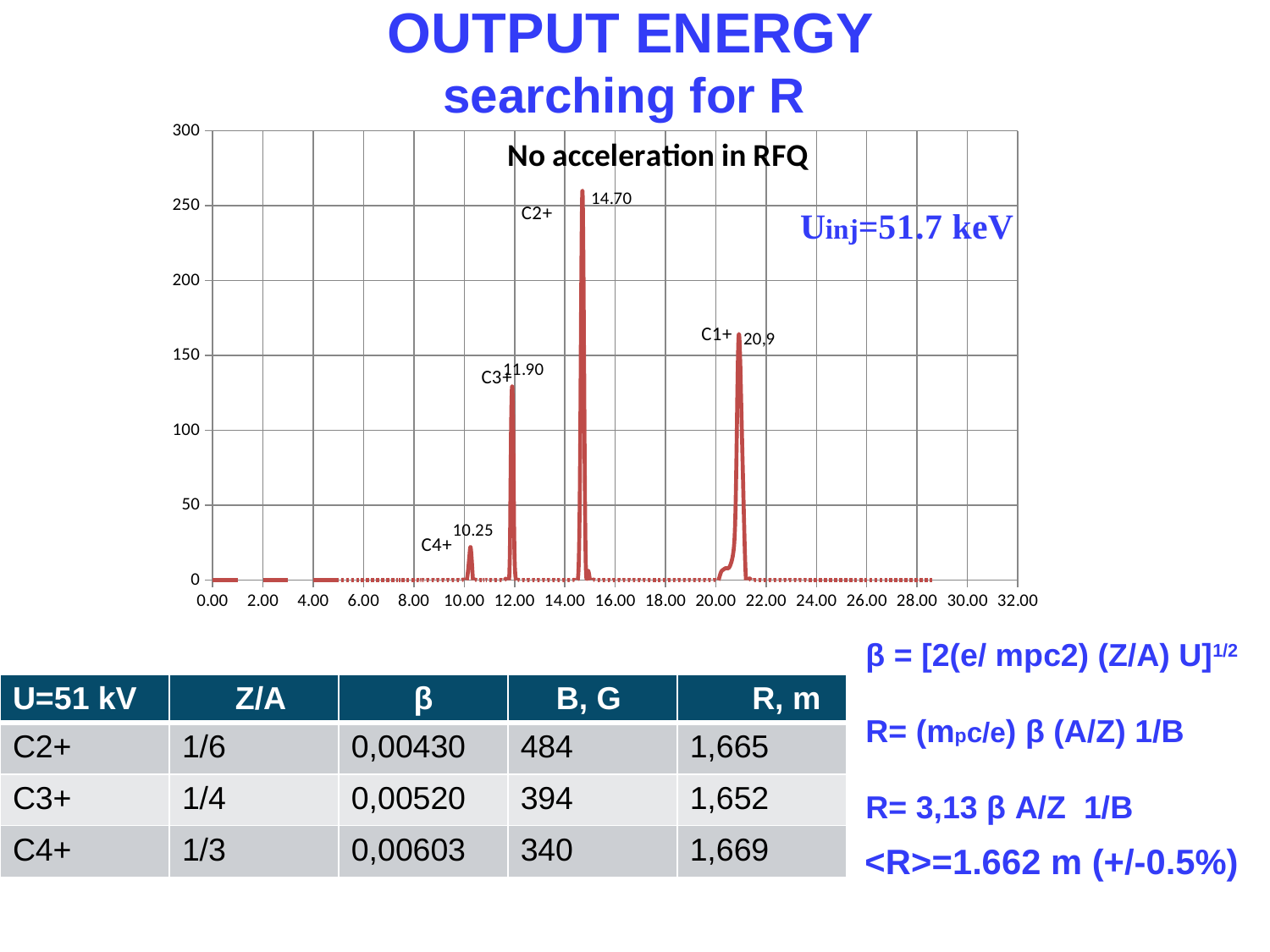
What kind of chart is shown on the slide? line chart Which labeled peak reaches the highest value on the y axis? C2+ What is the title printed inside the chart area? No acceleration in RFQ How many labeled peaks are there in the chart? 4 What value is labeled at the C4+ peak? 10.25 What value is labeled at the C3+ peak? 11.90 What value is labeled at the C2+ peak? 14.70 What value is labeled at the C1+ peak? 20,9 Is the height of the C2+ peak greater or less than 200? greater Which labeled peak reaches the lowest value on the y axis? C4+ Is the height of the C4+ peak greater or less than 50? less Which peak is taller, C1+ or C3+? C1+